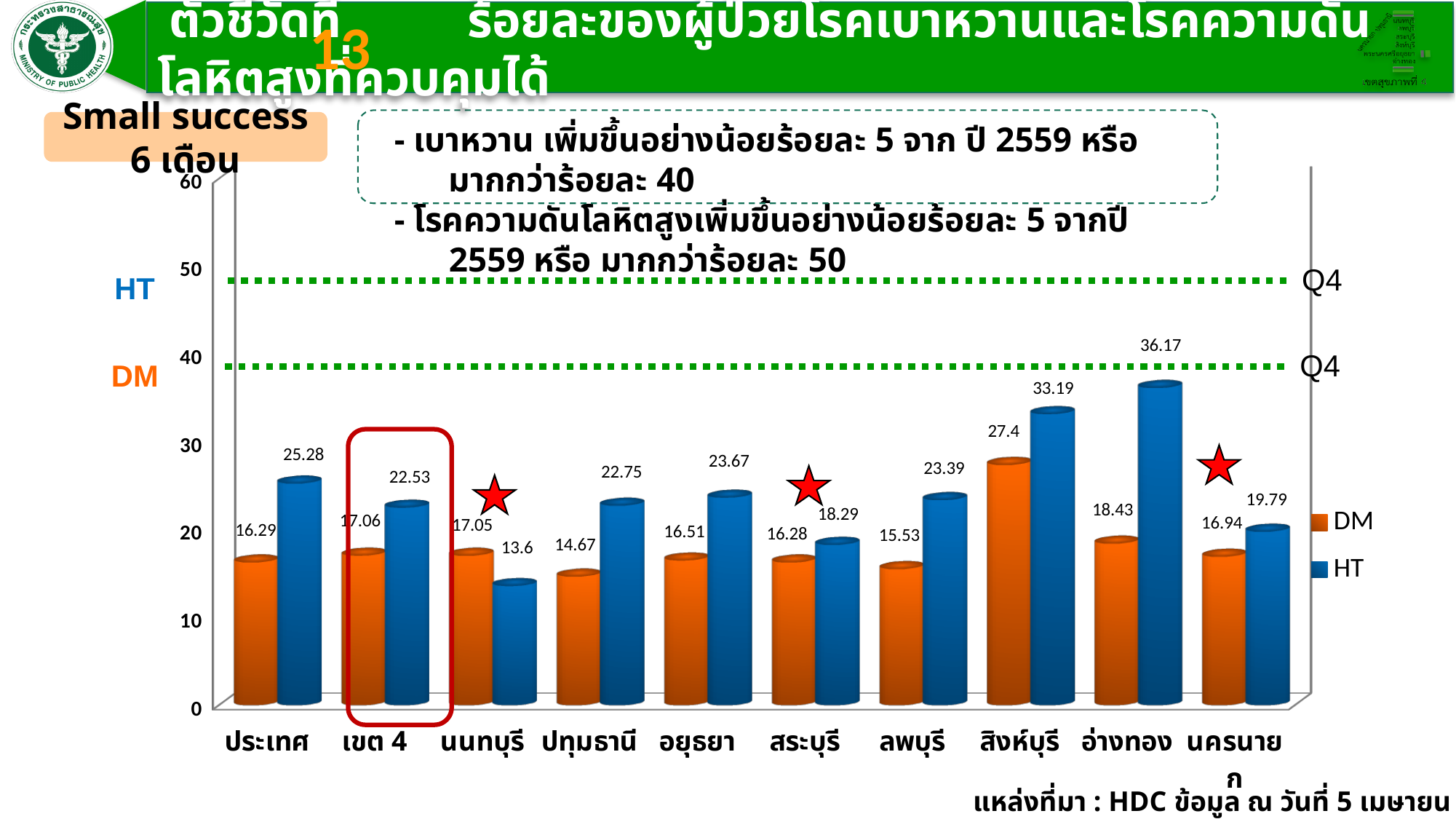
Which category has the highest DM value? สิงห์บุรี What is the HT value for อ่างทอง? 36.17 What is the DM value for สิงห์บุรี? 27.4 For นนทบุรี, which is larger, the DM value or the HT value? DM Which category has the highest HT value? อ่างทอง Which category has the lowest HT value? นนทบุรี How many categories are shown on the x axis? 10 What is the DM value for ปทุมธานี? 14.67 What is the HT value for ประเทศ? 25.28 What kind of chart is shown on the slide? Bar chart What is the difference between the HT and DM values for สิงห์บุรี? 5.79 How many series does the legend list? 2